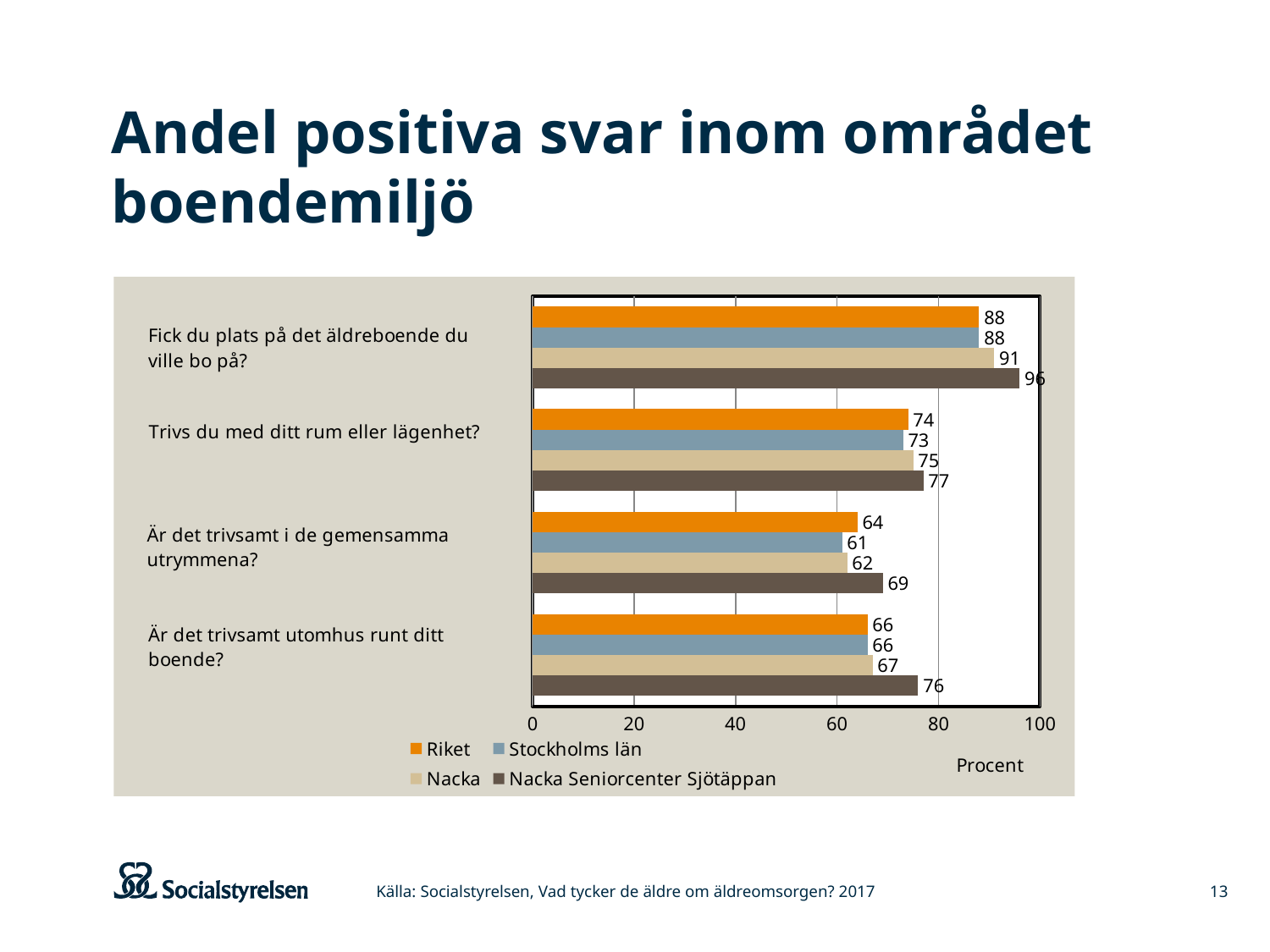
Which is larger on "Trivs du med ditt rum eller lägenhet?": Nacka or Stockholms län? Nacka What is the difference between Nacka Seniorcenter Sjötäppan and Riket on "Är det trivsamt utomhus runt ditt boende?"? 10 Which series has the highest value on "Är det trivsamt utomhus runt ditt boende?"? Nacka Seniorcenter Sjötäppan What kind of chart is shown on the slide? Bar chart What is the value for Nacka on "Är det trivsamt utomhus runt ditt boende?"? 67 Which series has the lowest value on "Är det trivsamt i de gemensamma utrymmena?"? Stockholms län What is the value for Stockholms län on "Är det trivsamt i de gemensamma utrymmena?"? 61 How many question categories are shown on the chart? 4 What is the value for Riket on "Trivs du med ditt rum eller lägenhet?"? 74 How many series does the legend list? 4 What is the label on the horizontal axis of the chart? Procent What is the value for Nacka Seniorcenter Sjötäppan on "Fick du plats på det äldreboende du ville bo på?"? 96